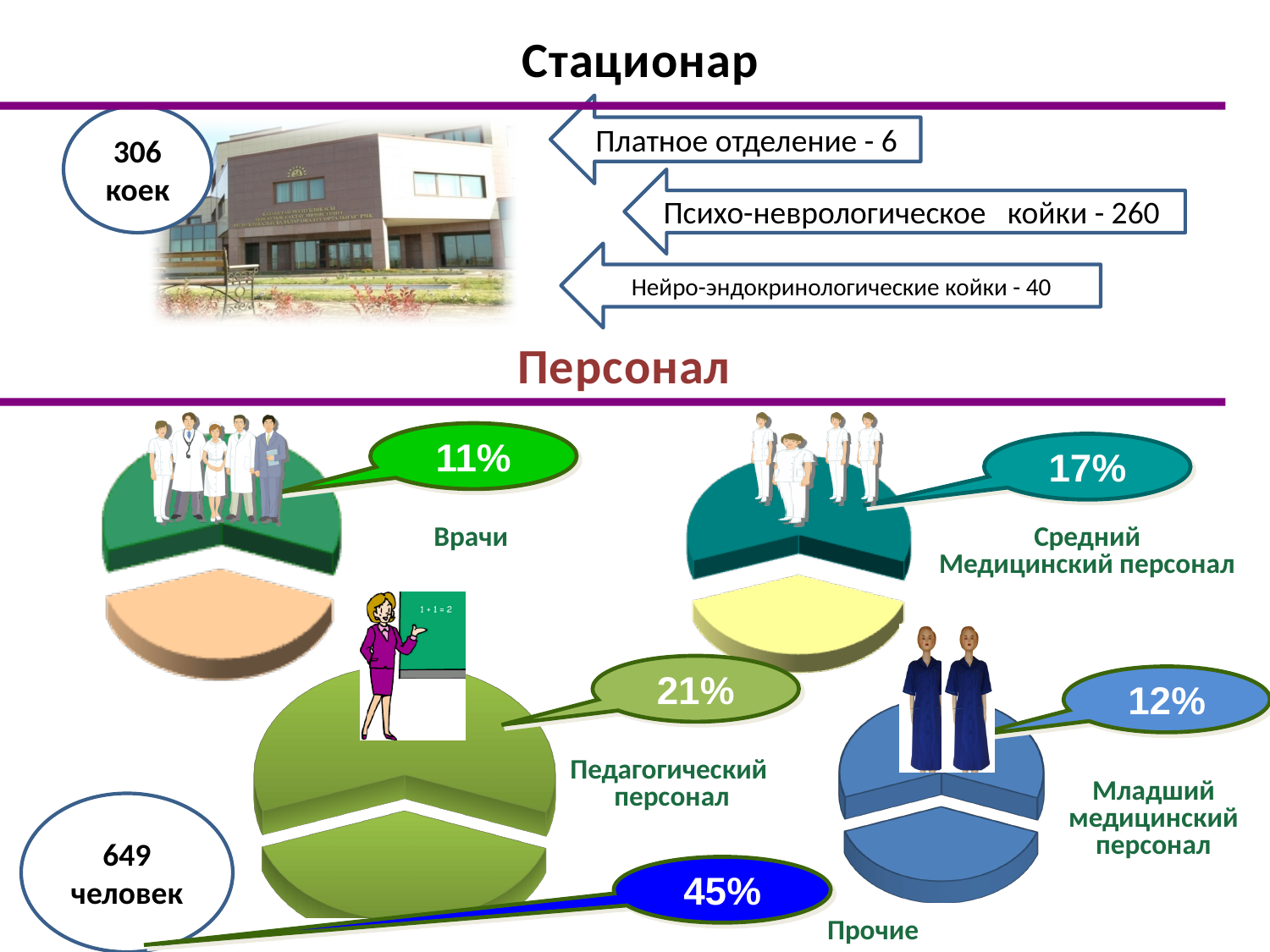
In the Персонал section, what percentage is shown for Младший медицинский персонал? 12% In the Персонал section, what is the difference in percentage points between Педагогический персонал and Врачи? 10 In the Персонал section, what percentage is shown for Прочие? 45% In the Персонал section, what percentage is shown for Средний медицинский персонал? 17% In the Персонал section, which is larger: the percentage for Средний медицинский персонал or for Младший медицинский персонал? Средний медицинский персонал In the Персонал section, which staff category has the lowest percentage? Врачи In the Персонал section, what percentage is shown for Врачи? 11% In the Персонал section, which staff category has the highest percentage? Прочие How many staff categories are shown with percentages in the Персонал section? 5 What total number of staff is shown in the Персонал section? 649 человек What kind of chart is used to show the staff percentages in the Персонал section? Pie chart In the Персонал section, what percentage is shown for Педагогический персонал? 21%